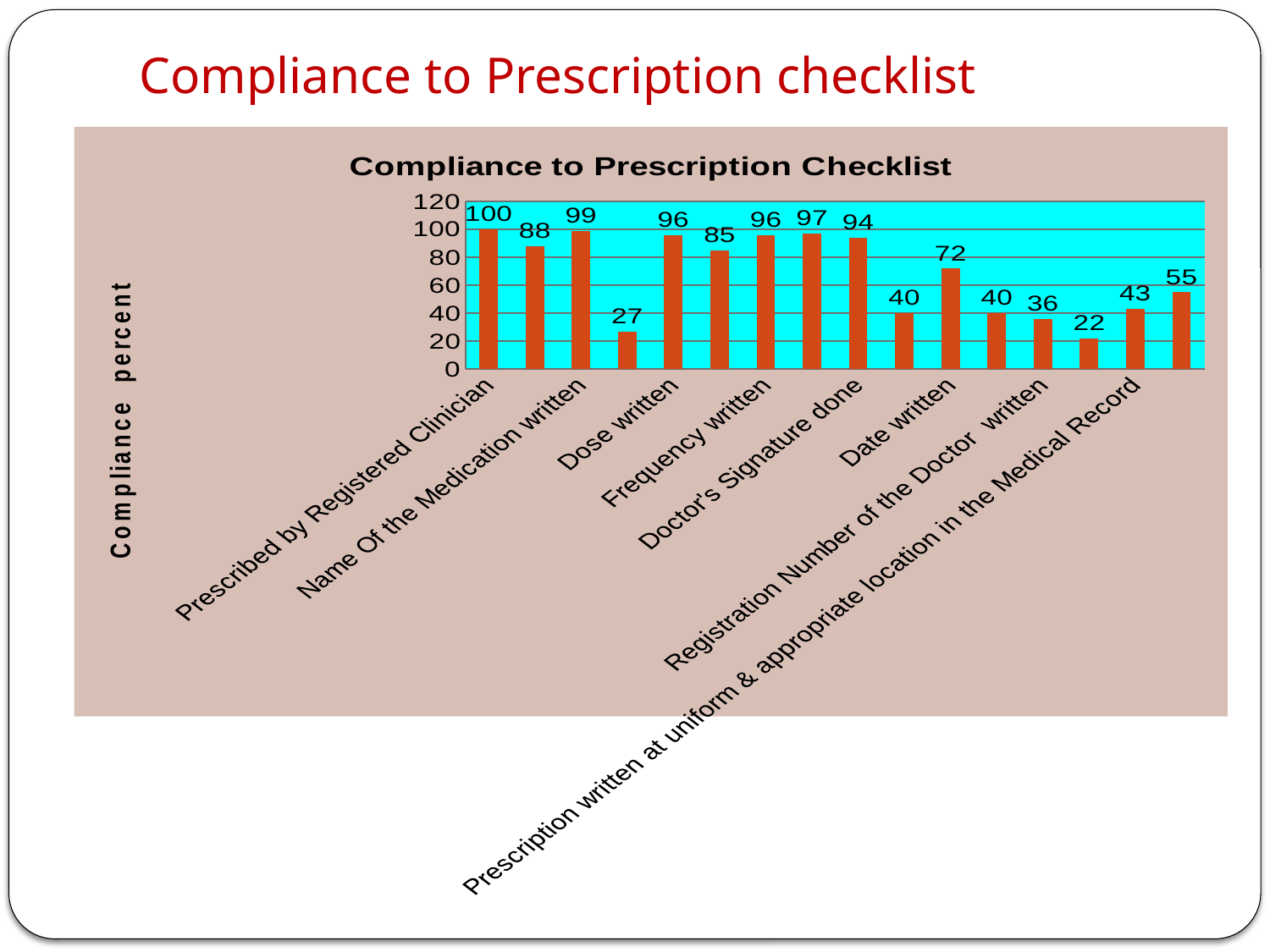
What is the value of the bar for Prescribed by Registered Clinician? 100 What is the lowest value shown by any bar in the chart? 22 What is the maximum value shown on the vertical axis of the chart? 120 Which is larger, the value of the leftmost bar or the value of the rightmost bar? the leftmost bar What is the value of the rightmost bar in the chart? 55 What is the label on the vertical axis of the chart? Compliance percent What is the title of the chart? Compliance to Prescription Checklist What is the highest value shown by any bar in the chart? 100 Is the value for Prescribed by Registered Clinician greater or less than 80? greater How many bars are plotted in the chart? 16 What type of chart is shown on the slide? bar chart What is the difference between the highest and lowest bar values in the chart? 78